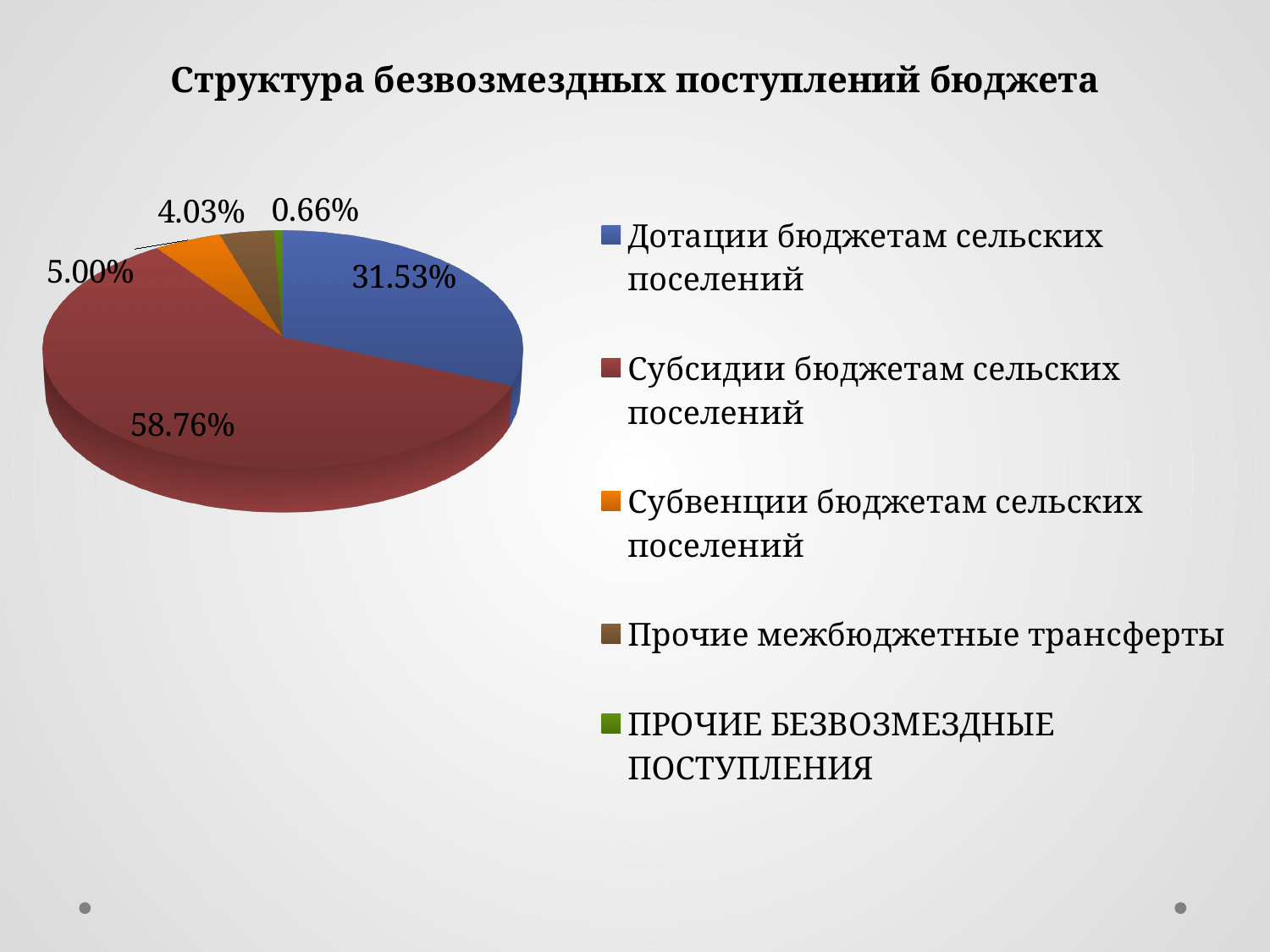
Which category has the smallest share of the pie? ПРОЧИЕ БЕЗВОЗМЕЗДНЫЕ ПОСТУПЛЕНИЯ Which category has the largest share of the pie? Субсидии бюджетам сельских поселений What type of chart is shown on the slide? Pie chart What share of the pie is labelled for Субвенции бюджетам сельских поселений? 5.00% What share of the pie is labelled for ПРОЧИЕ БЕЗВОЗМЕЗДНЫЕ ПОСТУПЛЕНИЯ? 0.66% What share of the pie is labelled for Субсидии бюджетам сельских поселений? 58.76% What is the difference in percentage points between Субсидии бюджетам сельских поселений and Дотации бюджетам сельских поселений? 27.23 What share of the pie is labelled for Прочие межбюджетные трансферты? 4.03% Which is larger: the share for Субвенции бюджетам сельских поселений or the share for Прочие межбюджетные трансферты? Субвенции бюджетам сельских поселений How many categories does the legend list? 5 What share of the pie is labelled for Дотации бюджетам сельских поселений? 31.53% What is the title of the chart? Структура безвозмездных поступлений бюджета